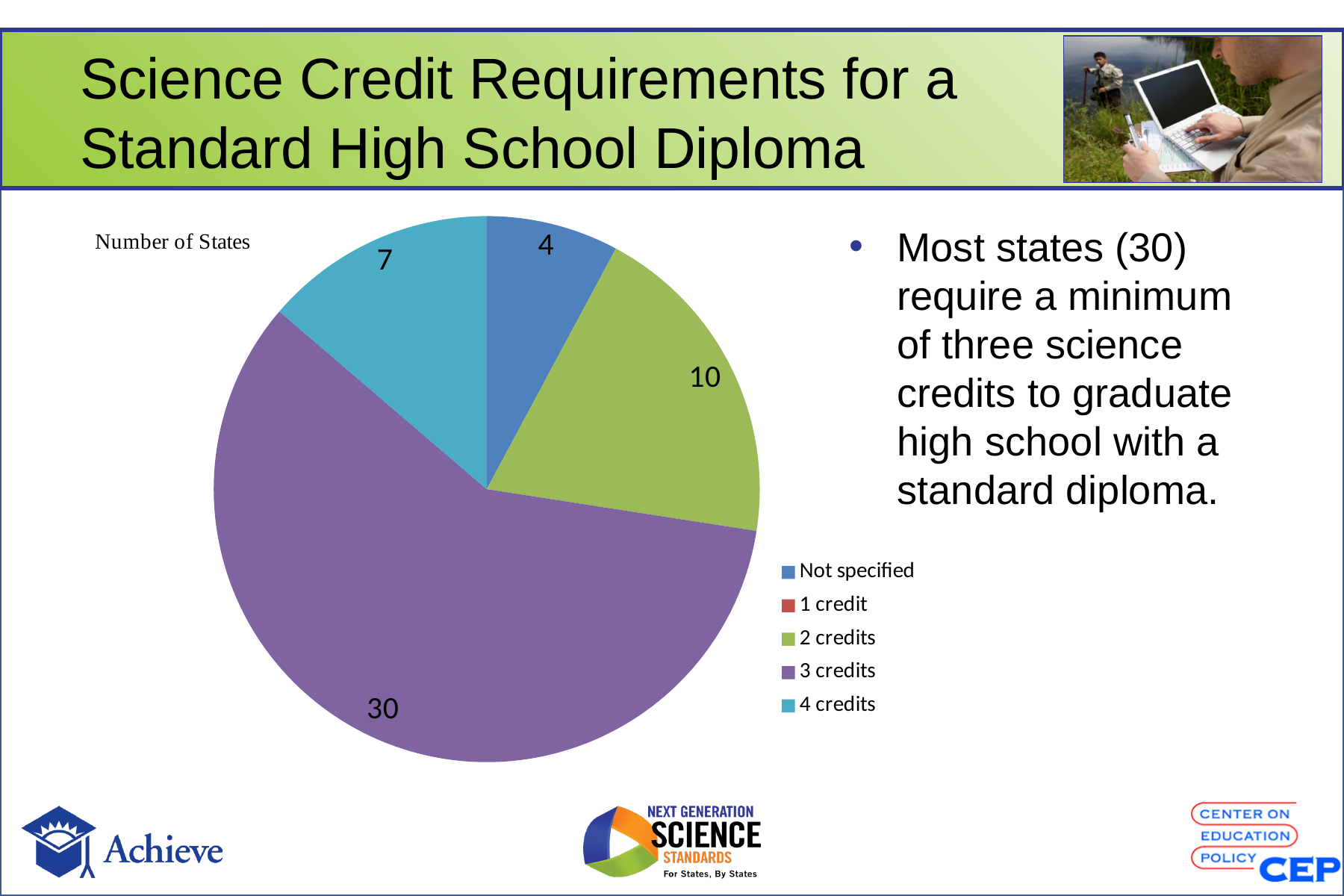
What label appears above the pie chart describing what the values represent? Number of States How many categories does the legend of the pie chart list? 5 What type of chart is shown on the slide? pie chart How many states require 4 credits of science? 7 How many states require 3 credits of science according to the pie chart? 30 What is the difference between the number of states requiring 3 credits and the number requiring 2 credits? 20 Which is larger: the number of states requiring 2 credits or the number requiring 4 credits? 2 credits Among the slices with printed values, which category has the smallest number of states? Not specified How many states have the science credit requirement 'Not specified'? 4 What is the difference between the number of states requiring 4 credits and the number with 'Not specified'? 3 How many states require 2 credits of science? 10 Which category has the largest slice of the pie chart? 3 credits